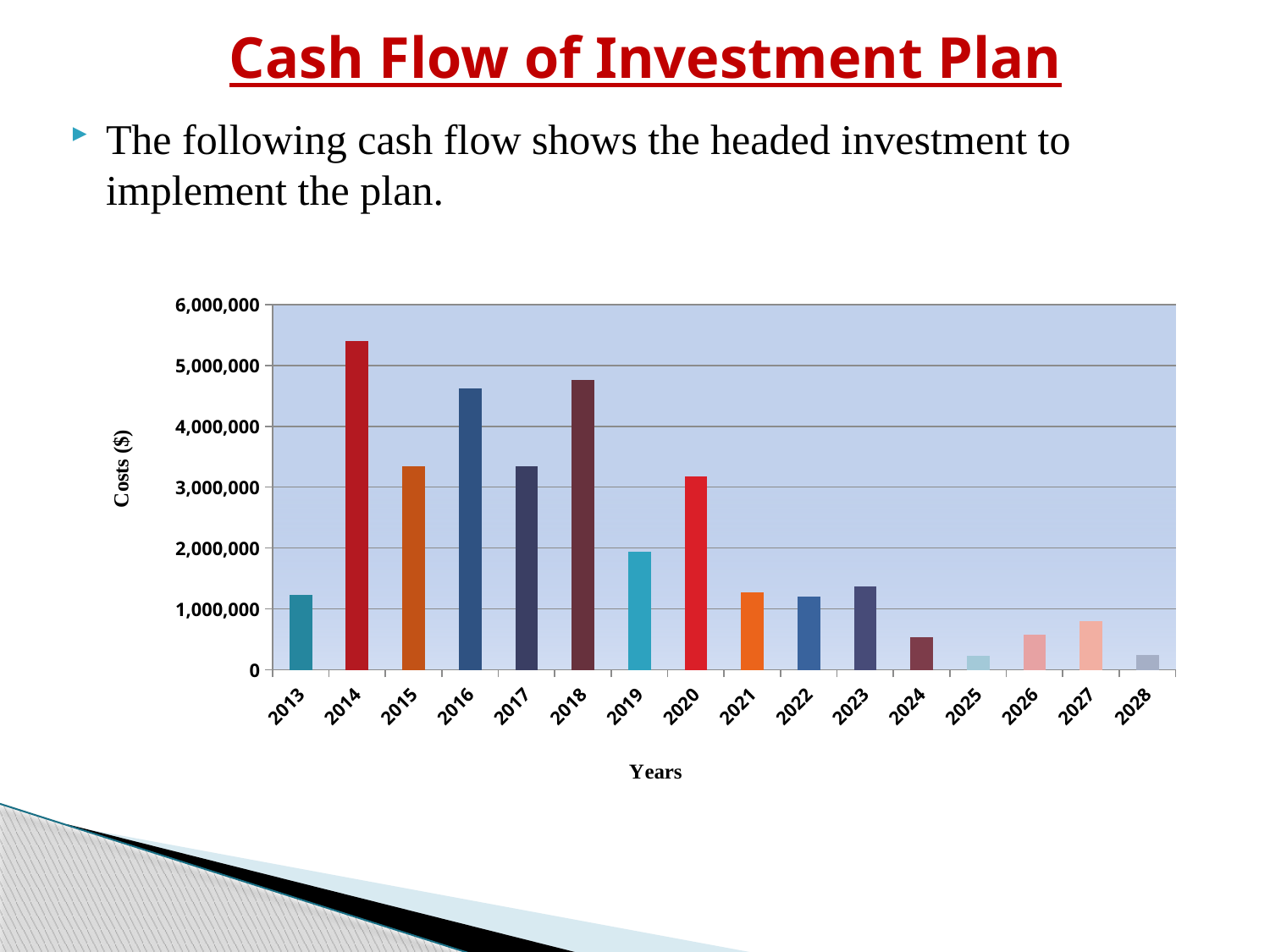
Is the value for 2024 greater or less than 1,000,000? less Is the value for 2014 greater or less than 5,000,000? greater Is the value for 2016 greater or less than 4,000,000? greater Which year has the larger cost, 2014 or 2018? 2014 Which year has the larger cost, 2019 or 2021? 2019 What kind of chart is shown on the slide? bar chart Which year has the highest cost in the chart? 2014 How many years are plotted on the x axis of the chart? 16 Do the costs generally rise or fall from 2020 to 2025? fall What is the title of the vertical axis of the chart? Costs ($)